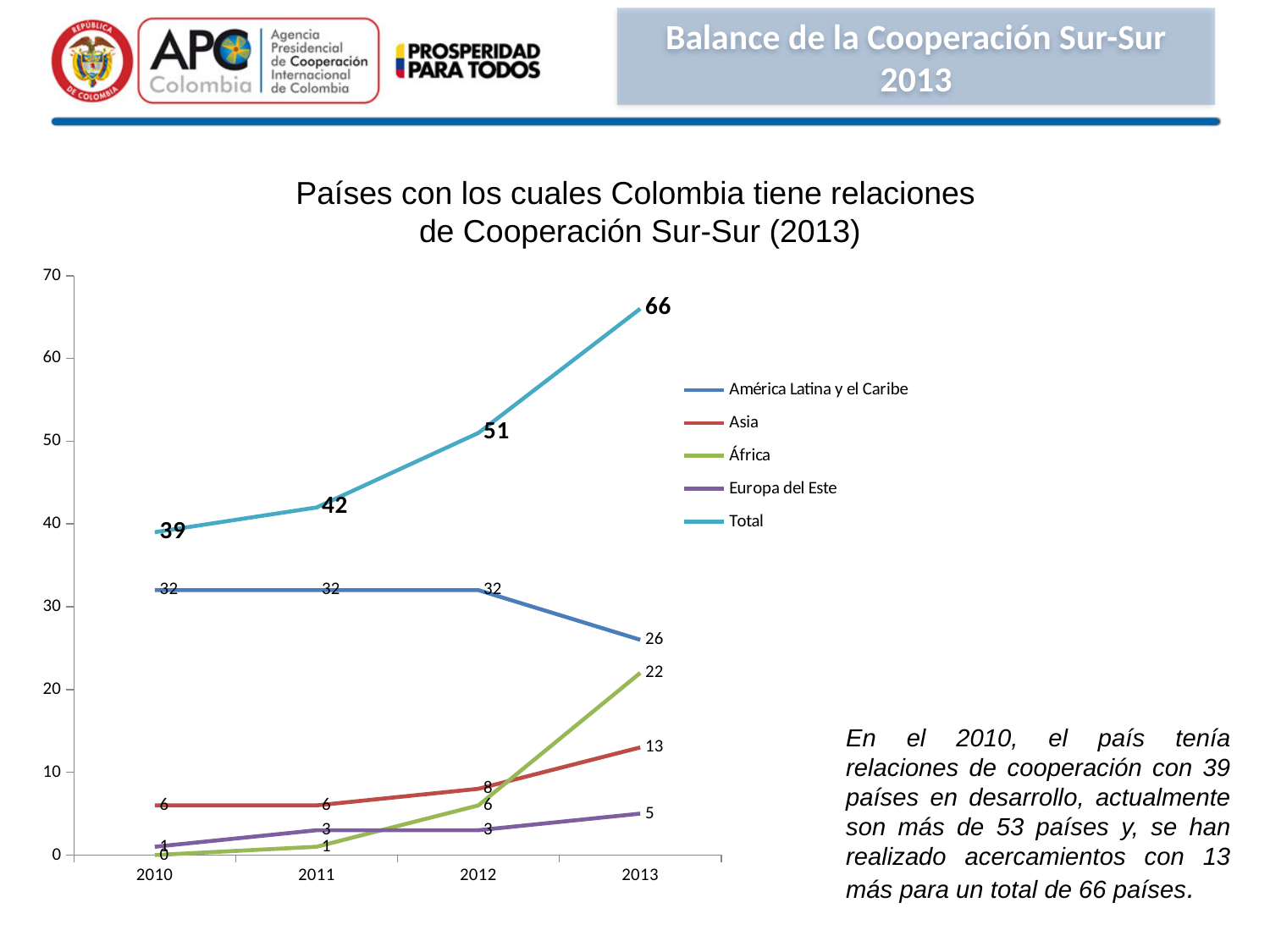
Does the Total series rise or fall from 2010 to 2013? rise What is the value for América Latina y el Caribe in 2013? 26 What is the difference between the Total values in 2013 and 2010? 27 In which year is the Total series highest? 2013 What is the value of the Total series in 2013? 66 Which series has the lowest value in 2013? Europa del Este How many years are shown on the x axis? 4 Which is larger in 2013, the value for Asia or the value for África? África What is the value for Asia in 2012? 8 What is the value for África in 2013? 22 How many series does the legend list? 5 What type of chart is shown on the slide? line chart